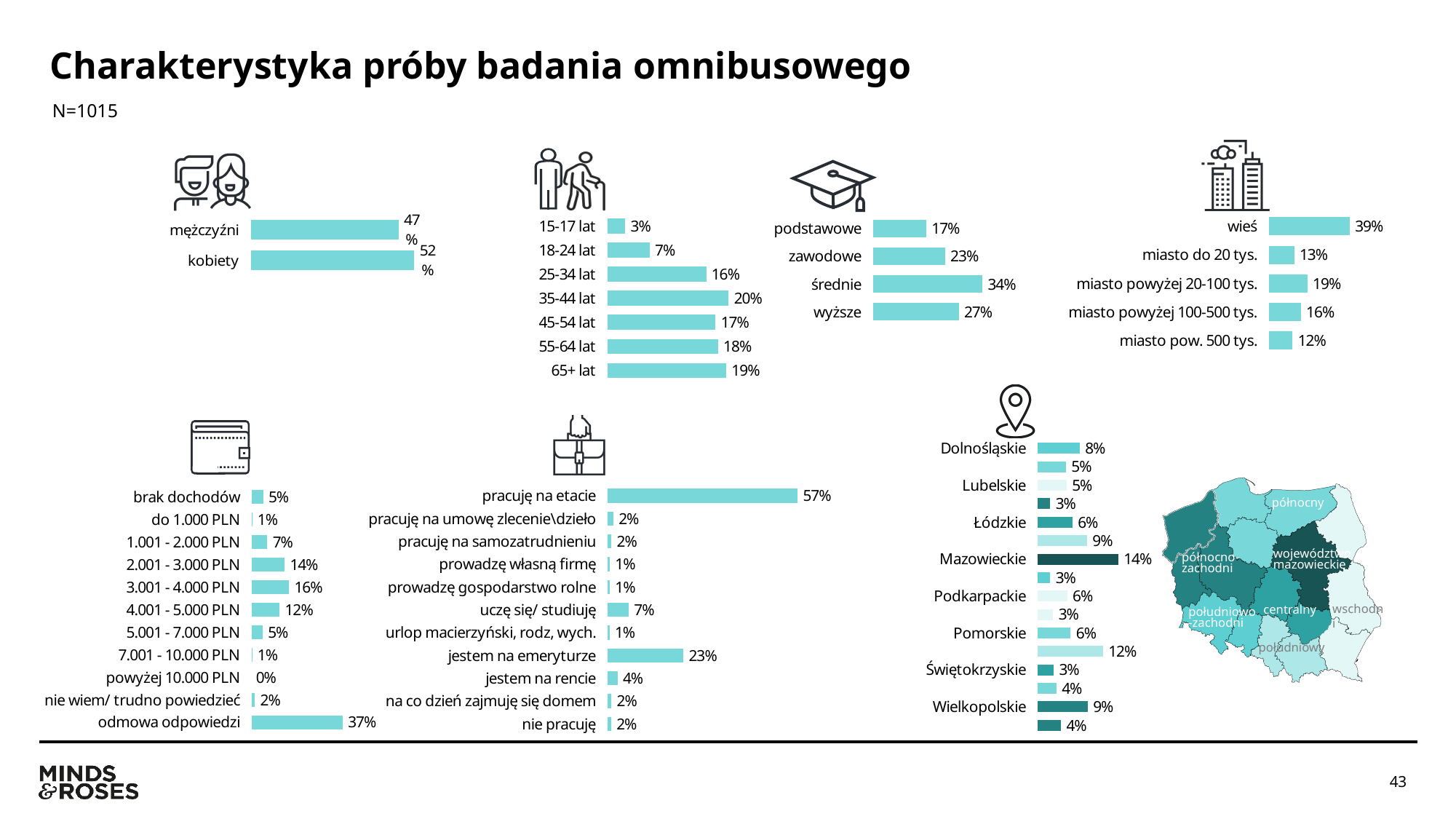
In the education chart (third chart in the top row), which category has the highest share? średnie In the income chart (bottom left), what percentage is shown for odmowa odpowiedzi? 37% In the education chart (third chart in the top row), what is the difference between the shares for średnie and wyższe? 7% In the voivodeship chart (bottom right), what percentage is shown for Mazowieckie? 14% In the age chart (second chart in the top row), what percentage of the sample is aged 35-44 lat? 20% In the place-of-residence chart (top right), what percentage of the sample lives in wieś? 39% In the age chart (second chart in the top row), which age group has the lowest share? 15-17 lat In the income chart (bottom left), which category has the lowest value? powyżej 10.000 PLN In the place-of-residence chart (top right), how many categories are shown? 5 In the employment chart (bottom middle), what percentage of respondents answered pracuję na etacie? 57% In the gender chart (top left), which is larger: mężczyźni or kobiety? kobiety In the employment chart (bottom middle), what is the difference between pracuję na etacie and jestem na emeryturze? 34%